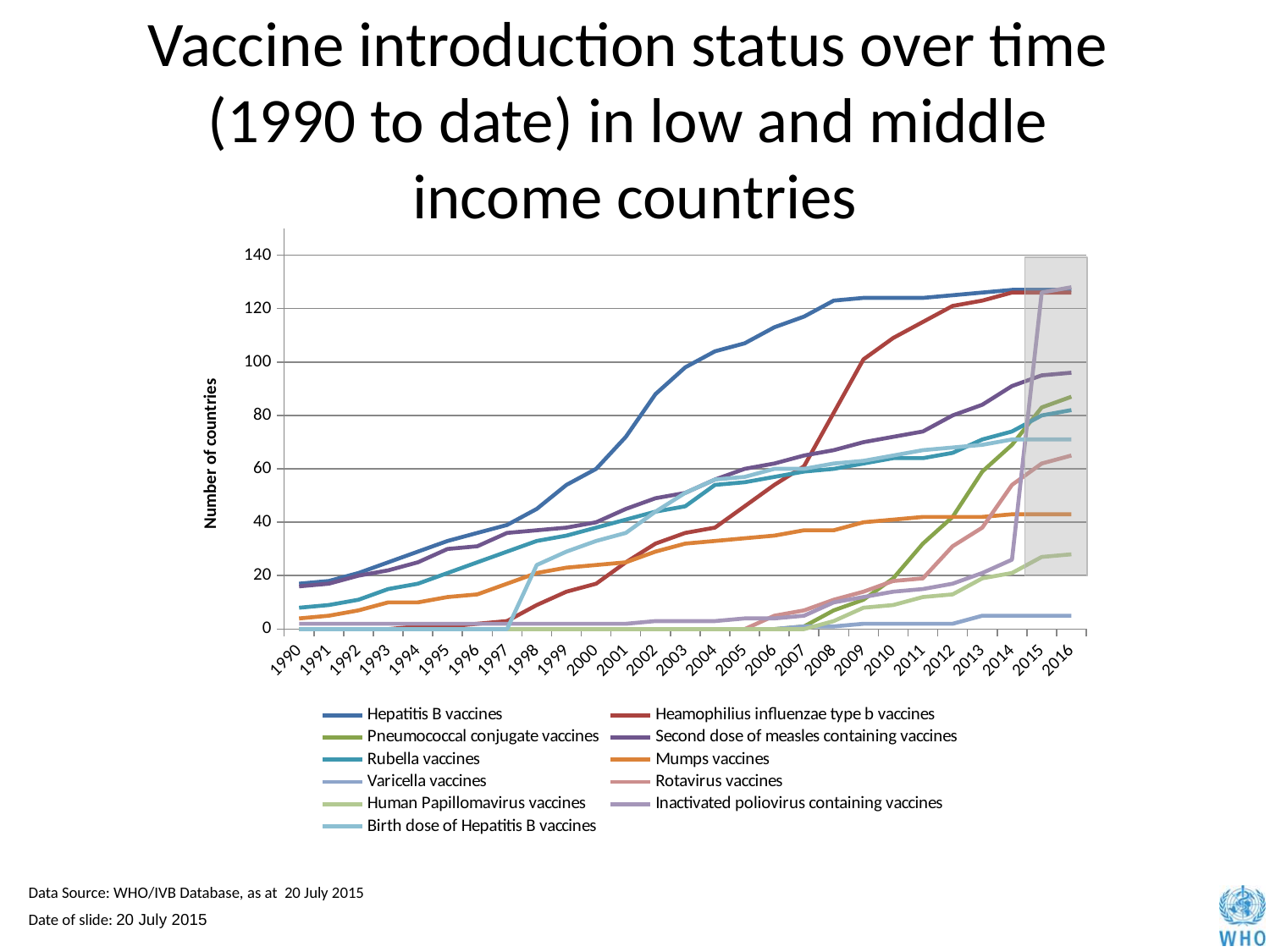
Is the value for Hepatitis B vaccines in 1990 greater or less than 20? less Is the value for Second dose of measles containing vaccines in 2016 greater or less than 80? greater What is the label of the y axis? Number of countries How many series does the legend list? 11 Which series has the highest value in 2010? Hepatitis B vaccines Is the value for Hepatitis B vaccines in 2016 greater or less than 120? greater How many years are shown along the x axis? 27 Does the Hepatitis B vaccines line rise or fall from 1990 to 2016? Rise What kind of chart is shown on the slide? Line chart Which series has the lowest value in 2016? Varicella vaccines In 2016, which is larger: Rubella vaccines or Mumps vaccines? Rubella vaccines